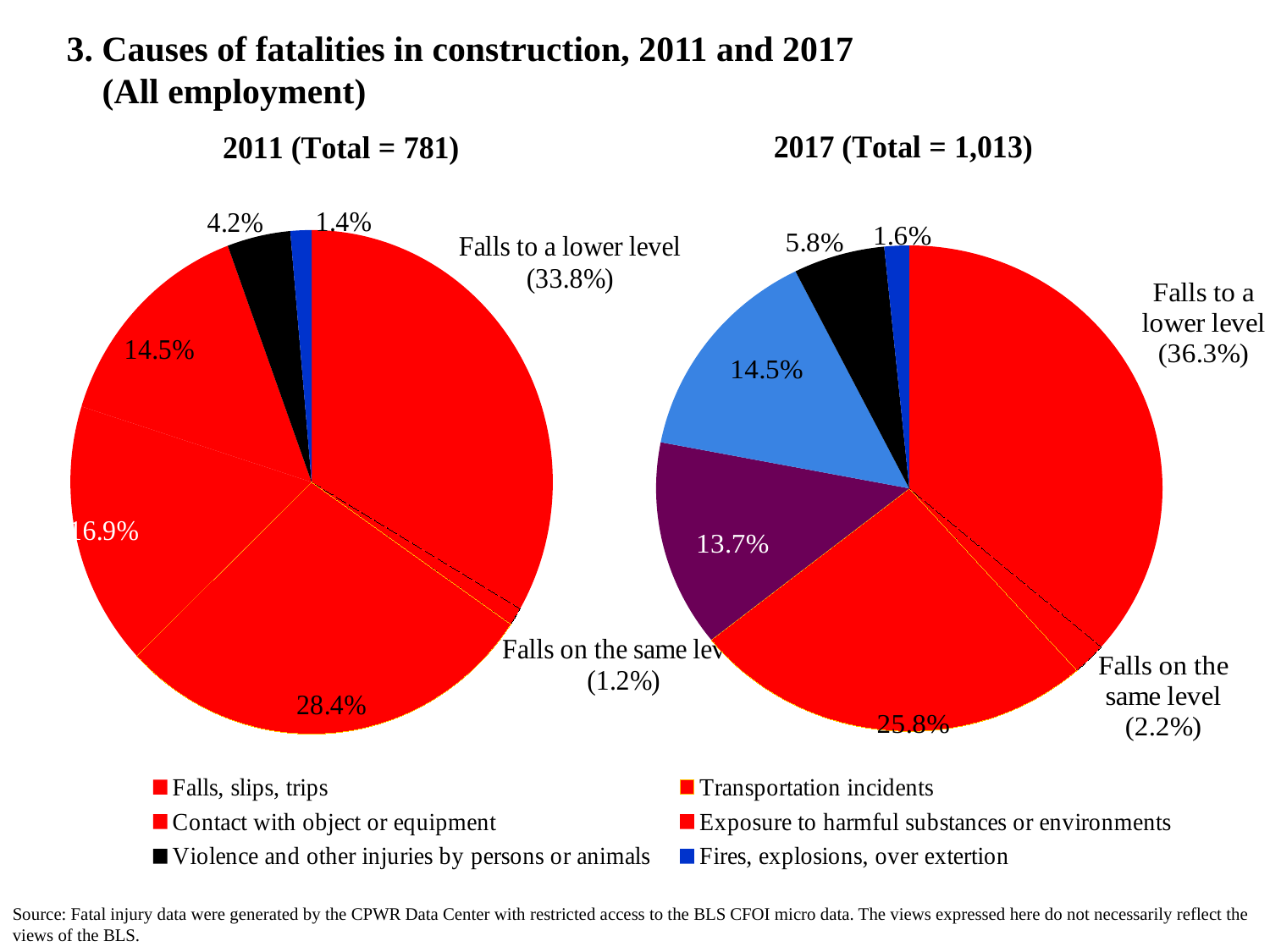
How many categories does the legend list? 6 In the 2011 pie chart, what share of fatalities is attributed to falls on the same level? 1.2% What total number of fatalities is given in the title of the 2011 pie chart? 781 By how many percentage points does the share for falls to a lower level in 2017 exceed that in 2011? 2.5 percentage points In the 2017 pie chart, what share of fatalities is attributed to falls to a lower level? 36.3% What kind of chart is used on this slide? Pie chart Is the share for falls to a lower level larger in the 2011 pie chart or the 2017 pie chart? 2017 In the 2017 pie chart, what share of fatalities is attributed to falls on the same level? 2.2% In the 2011 pie chart, what is the largest labeled slice? Falls to a lower level (33.8%) What total number of fatalities is given in the title of the 2017 pie chart? 1,013 In the 2017 pie chart, what is the smallest labeled slice value? 1.6%